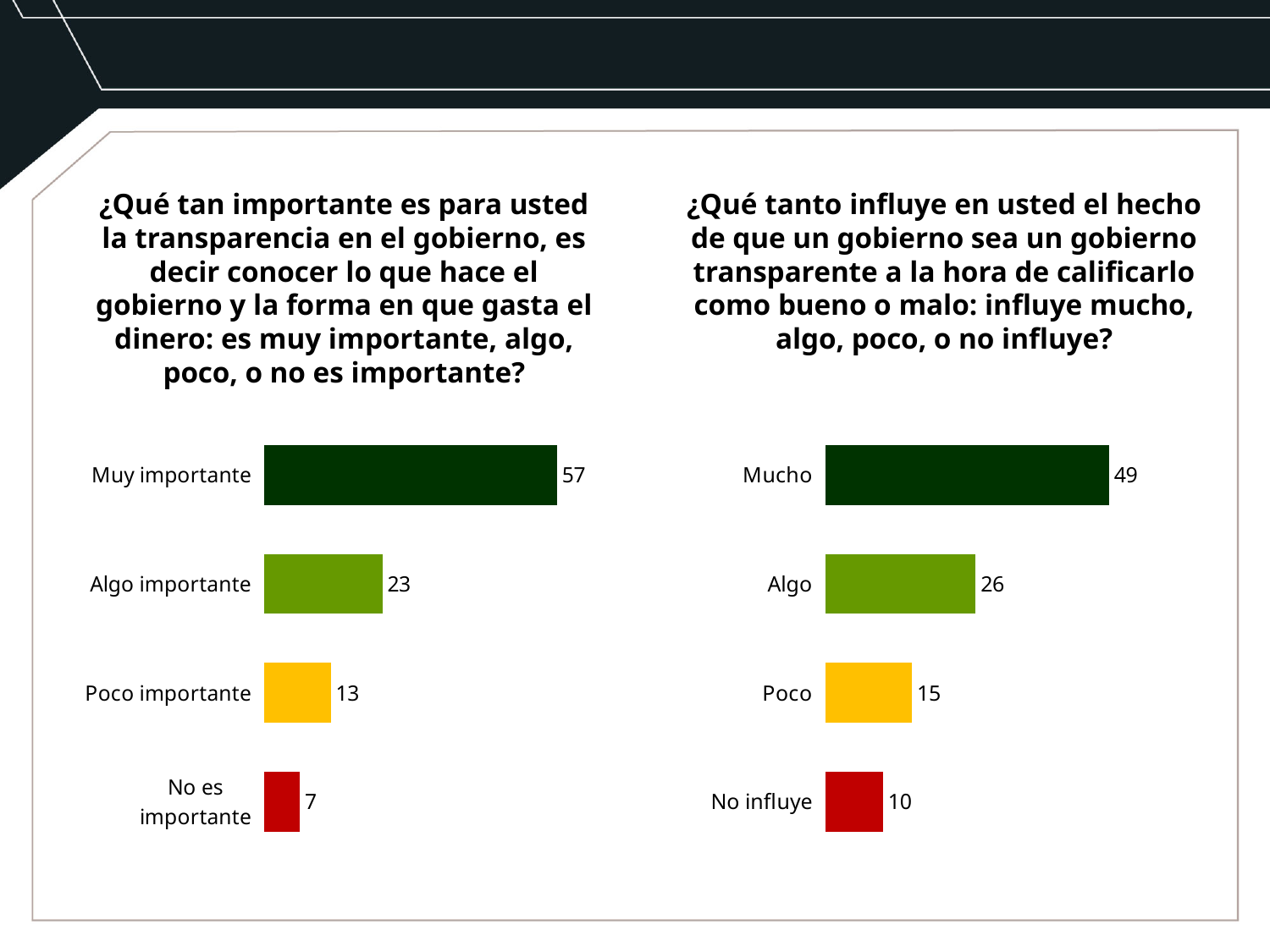
How many categories does the left chart (importance of transparency) show? 4 What kind of chart is the right chart (influence of transparency)? Bar chart In the right chart (influence of transparency), what is the value for "No influye"? 10 In the left chart (importance of transparency), what colour is the bar for "No es importante"? Red Which is larger: "Poco importante" in the left chart or "Poco" in the right chart? Poco in the right chart In the left chart (importance of transparency), what is the difference between "Muy importante" and "Algo importante"? 34 In the left chart (importance of transparency), what is the value for "Poco importante"? 13 In the right chart (influence of transparency), which category has the highest value? Mucho In the left chart (importance of transparency), what is the value for "Muy importante"? 57 In the right chart (influence of transparency), what is the difference between "Poco" and "No influye"? 5 In the right chart (influence of transparency), what is the value for "Algo"? 26 In the left chart (importance of transparency), which category has the lowest value? No es importante